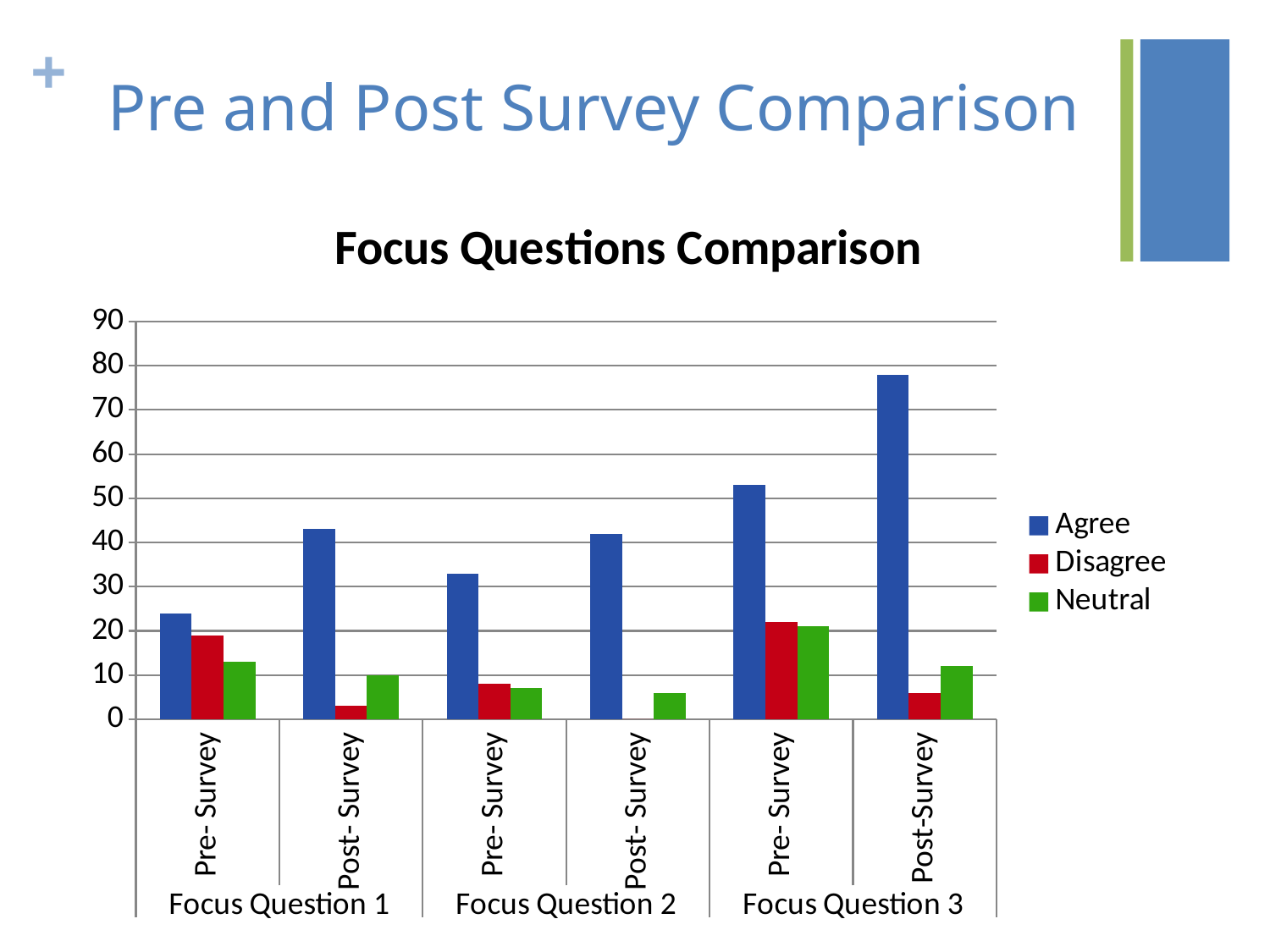
Is the Agree value for Focus Question 1 Pre-Survey greater or less than 30? less Which is larger, the Agree value for Focus Question 1 Pre-Survey or for Focus Question 1 Post-Survey? Focus Question 1 Post-Survey Is the Agree value for Focus Question 3 Pre-Survey greater or less than 50? greater Is the Disagree value for Focus Question 1 Post-Survey greater or less than 10? less Which series is shown in blue in the legend? Agree What kind of chart is shown on the slide? bar chart How many series does the legend list? 3 Which is larger, the Disagree value for Focus Question 3 Pre-Survey or for Focus Question 3 Post-Survey? Focus Question 3 Pre-Survey How many survey categories (Pre/Post groups) are shown along the x axis? 6 Which category has the highest Agree value? Focus Question 3 Post-Survey What is the title of the chart? Focus Questions Comparison